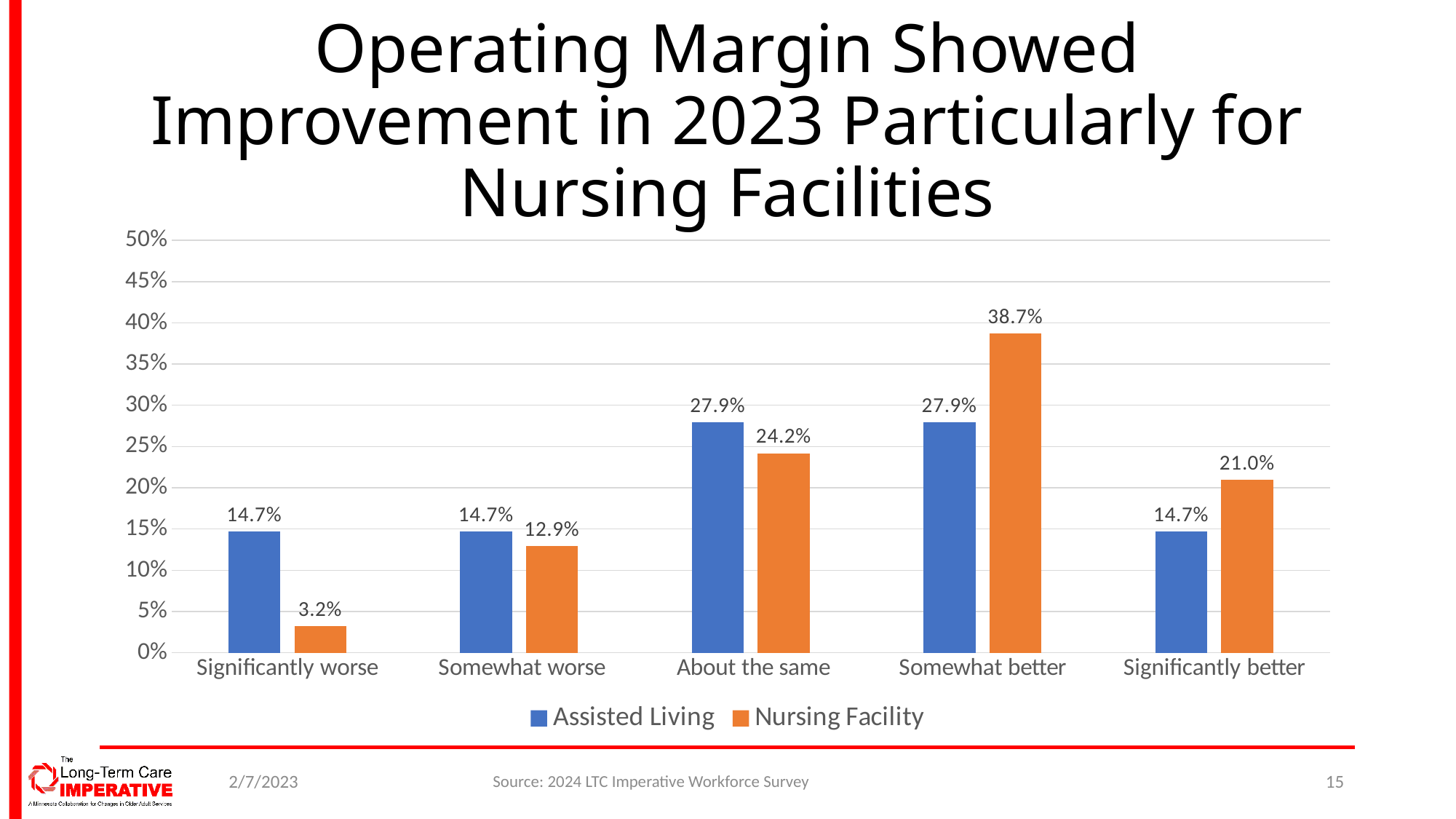
Which category has the lowest Nursing Facility value? Significantly worse Is the Nursing Facility value for About the same greater or less than 25%? less What kind of chart is shown on the slide? bar chart What is the Nursing Facility value for Significantly worse? 3.2% For Significantly better, which series has the larger value, Assisted Living or Nursing Facility? Nursing Facility How many categories are shown on the x axis? 5 What is the Assisted Living value for About the same? 27.9% What is the Nursing Facility value for Somewhat better? 38.7% Which category has the highest Nursing Facility value? Somewhat better What is the difference between the Assisted Living and Nursing Facility values for Significantly worse? 11.5% What is the difference between the Nursing Facility and Assisted Living values for Somewhat better? 10.8% How many series does the legend list? 2